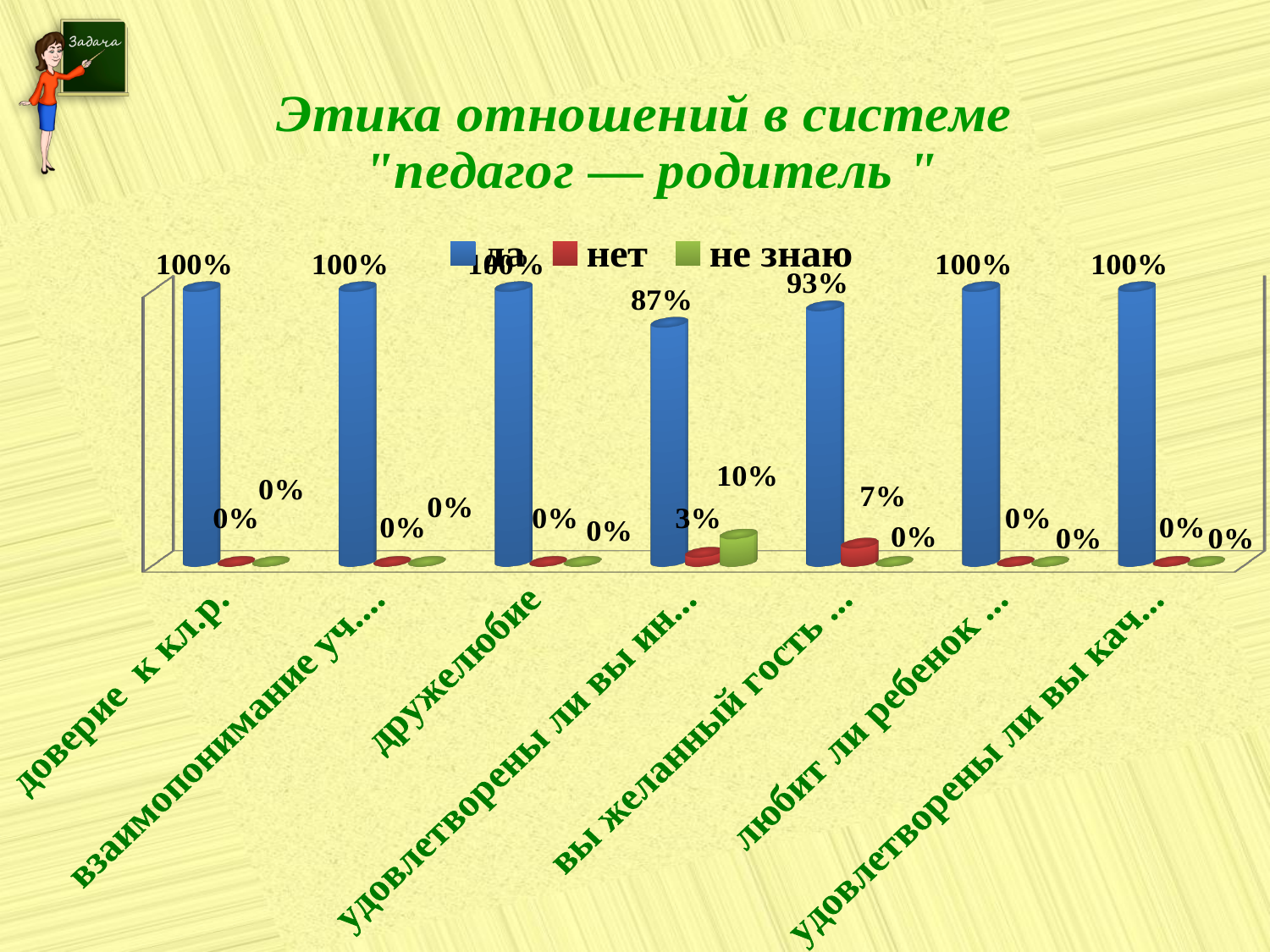
What is the difference between the "да" values for "дружелюбие" and "удовлетворены ли вы ин..."? 13% Which is larger: the "да" value for "вы желанный гость ..." or the "да" value for "удовлетворены ли вы ин..."? вы желанный гость ... How many categories are shown on the x axis? 7 What is the value of the "да" series for "дружелюбие"? 100% What kind of chart is shown on the slide? bar chart What is the value of the "нет" series for the category "вы желанный гость ..."? 7% What is the value of the "нет" series for "доверие к кл.р."? 0% What is the value of the "да" series for the category "вы желанный гость ..."? 93% What is the title of the slide containing the chart? Этика отношений в системе "педагог — родитель" Which category has the lowest value in the "да" series? удовлетворены ли вы ин... What is the value of the "не знаю" series for the category "удовлетворены ли вы ин..."? 10% How many series does the legend list? 3